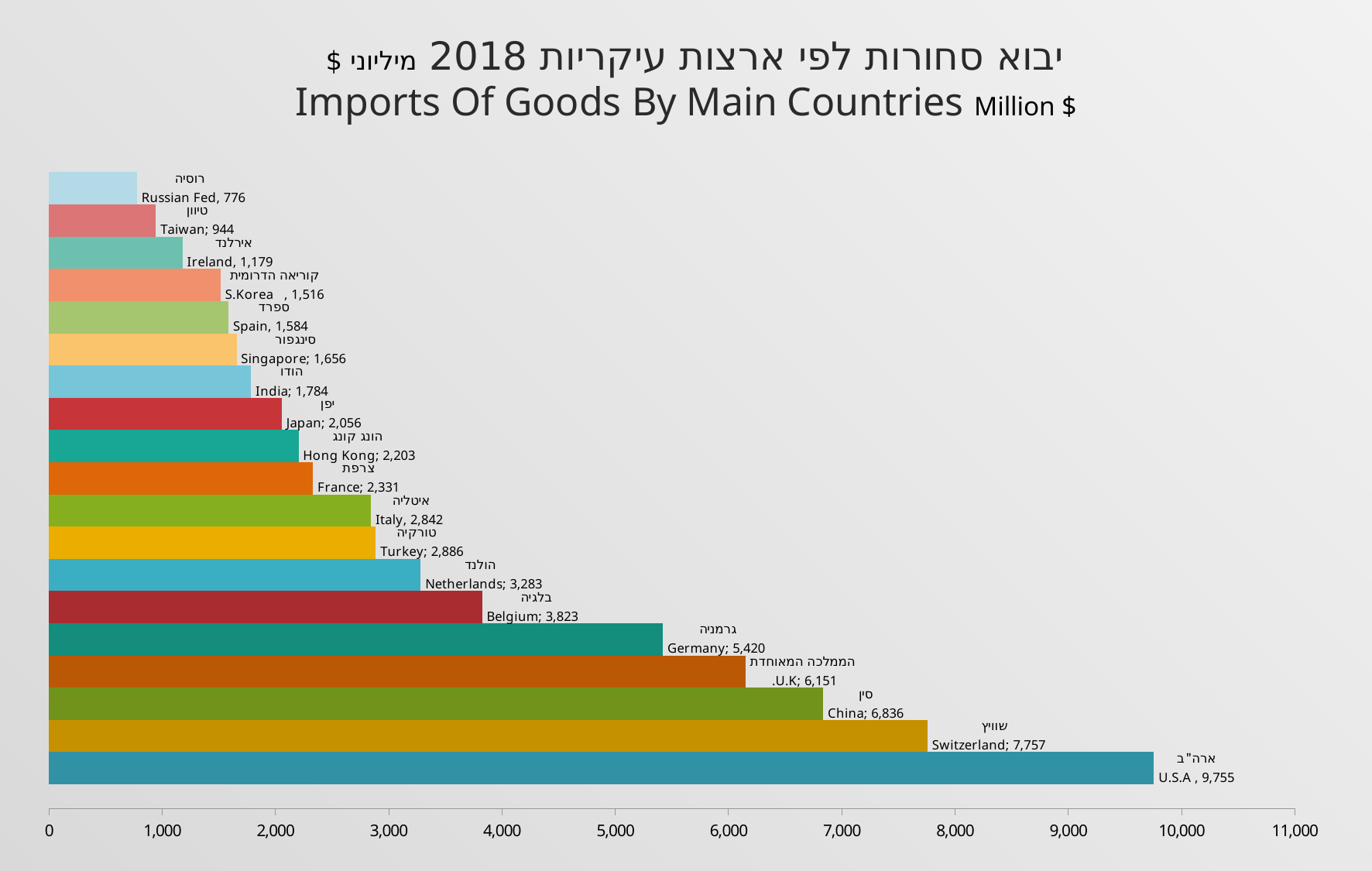
What is the difference between the values for U.S.A and Switzerland? 1,998 Which is larger, the value for Belgium or the value for Netherlands? Belgium What is the value for Switzerland? 7,757 How many countries are shown in the chart? 19 What is the difference between the values for China and U.K? 685 Which country has the lowest imports value? Russian Fed What kind of chart is shown on the slide? bar chart Is the value for Germany greater or less than 5,000? greater Which country has the highest imports value? U.S.A What is the value for Hong Kong? 2,203 What is the value for Germany? 5,420 What unit is stated in the chart title? Million $